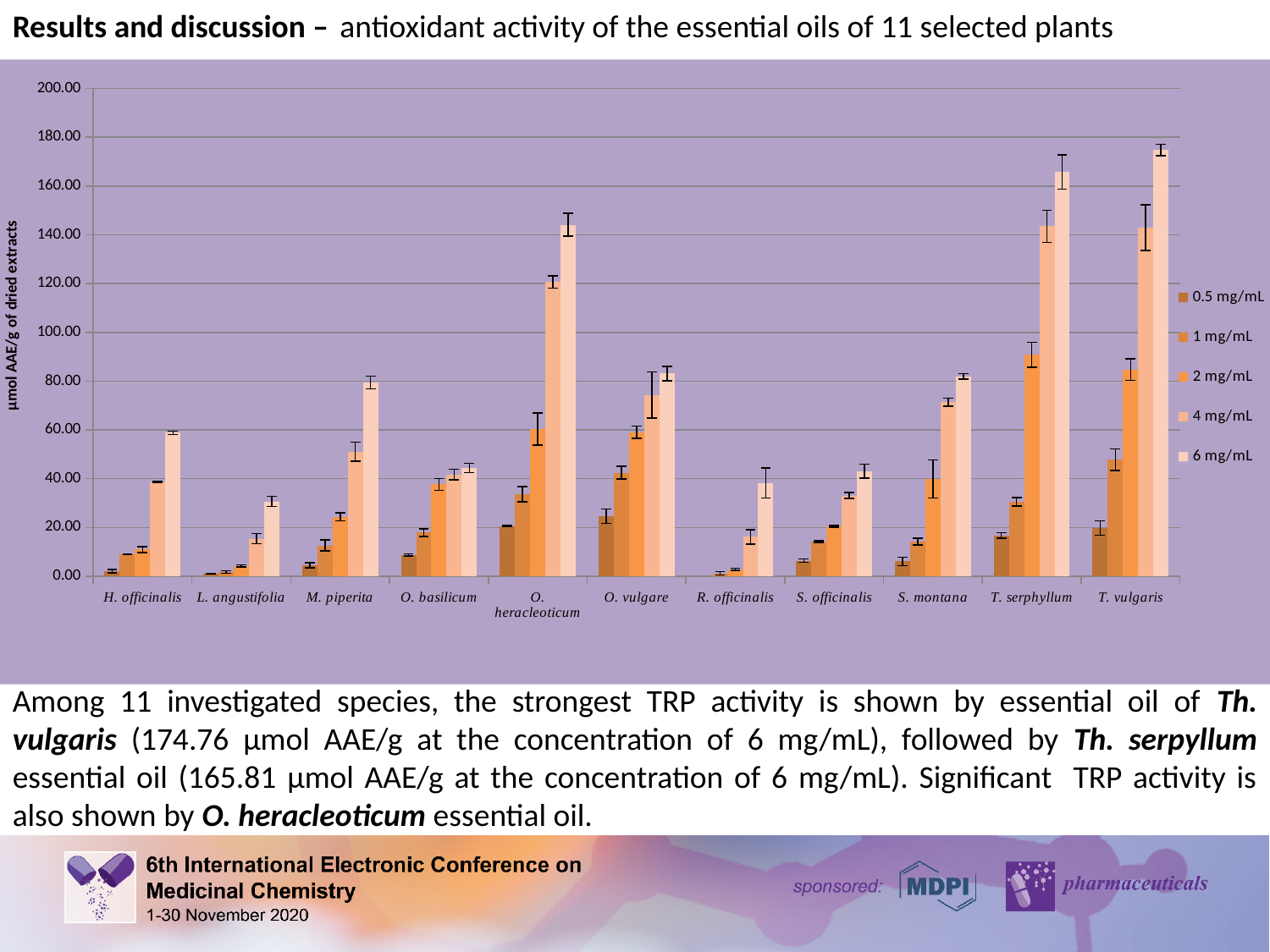
Which plant has the highest value at 6 mg/mL? T. vulgaris Which plant has the lowest value at 6 mg/mL? L. angustifolia At 4 mg/mL, which has the larger value: S. montana or S. officinalis? S. montana Is the value for T. serphyllum at 6 mg/mL greater or less than 160.00? greater What is the label of the y axis of the chart? μmol AAE/g of dried extracts At 6 mg/mL, which has the larger value: O. vulgare or O. basilicum? O. vulgare Is the value for O. heracleoticum at 6 mg/mL greater or less than 120.00? greater Is the value for H. officinalis at 6 mg/mL greater or less than 40.00? greater What kind of chart is shown on the slide? bar chart How many plant species (categories) are shown on the x axis of the chart? 11 How many series does the chart legend list? 5